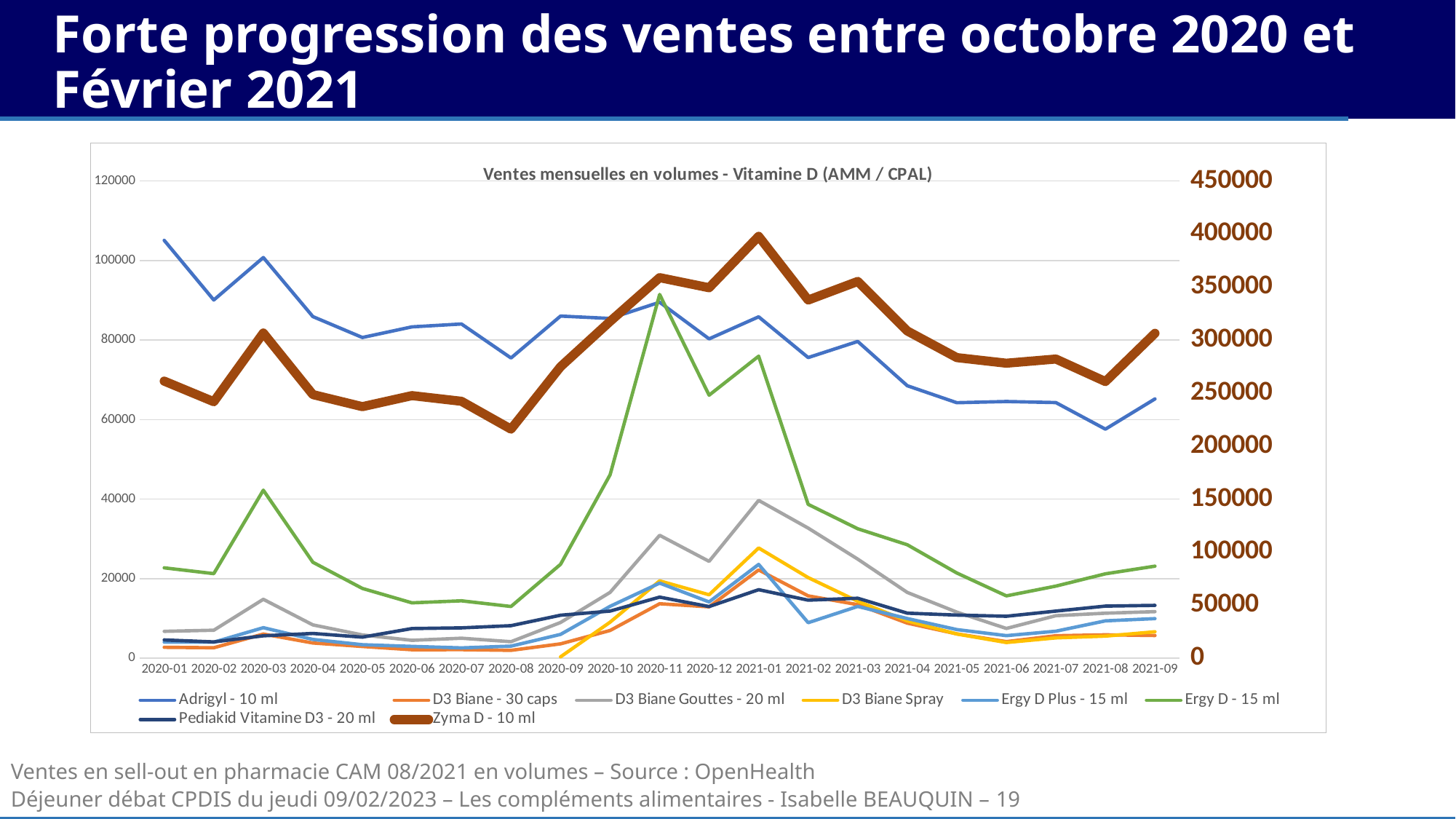
What is the title of the chart? Ventes mensuelles en volumes - Vitamine D (AMM / CPAL) In which month does the Adrigyl - 10 ml series reach its highest value? 2020-01 In which month does the Ergy D - 15 ml series reach its highest value? 2020-11 Does the Zyma D - 10 ml series rise or fall between 2020-08 and 2021-01? Rise Is the value for Zyma D - 10 ml in 2020-08 greater or less than 250000 on the right axis? less How many series does the legend list? 8 Which series is drawn with the thick brown line? Zyma D - 10 ml How many months are shown along the x axis? 21 Which is larger in 2020-01: Adrigyl - 10 ml or Ergy D - 15 ml? Adrigyl - 10 ml Is the value for Adrigyl - 10 ml in 2020-01 greater or less than 100000 on the left axis? greater In which month does the Zyma D - 10 ml series reach its highest value? 2021-01 What kind of chart is shown on the slide? Line chart